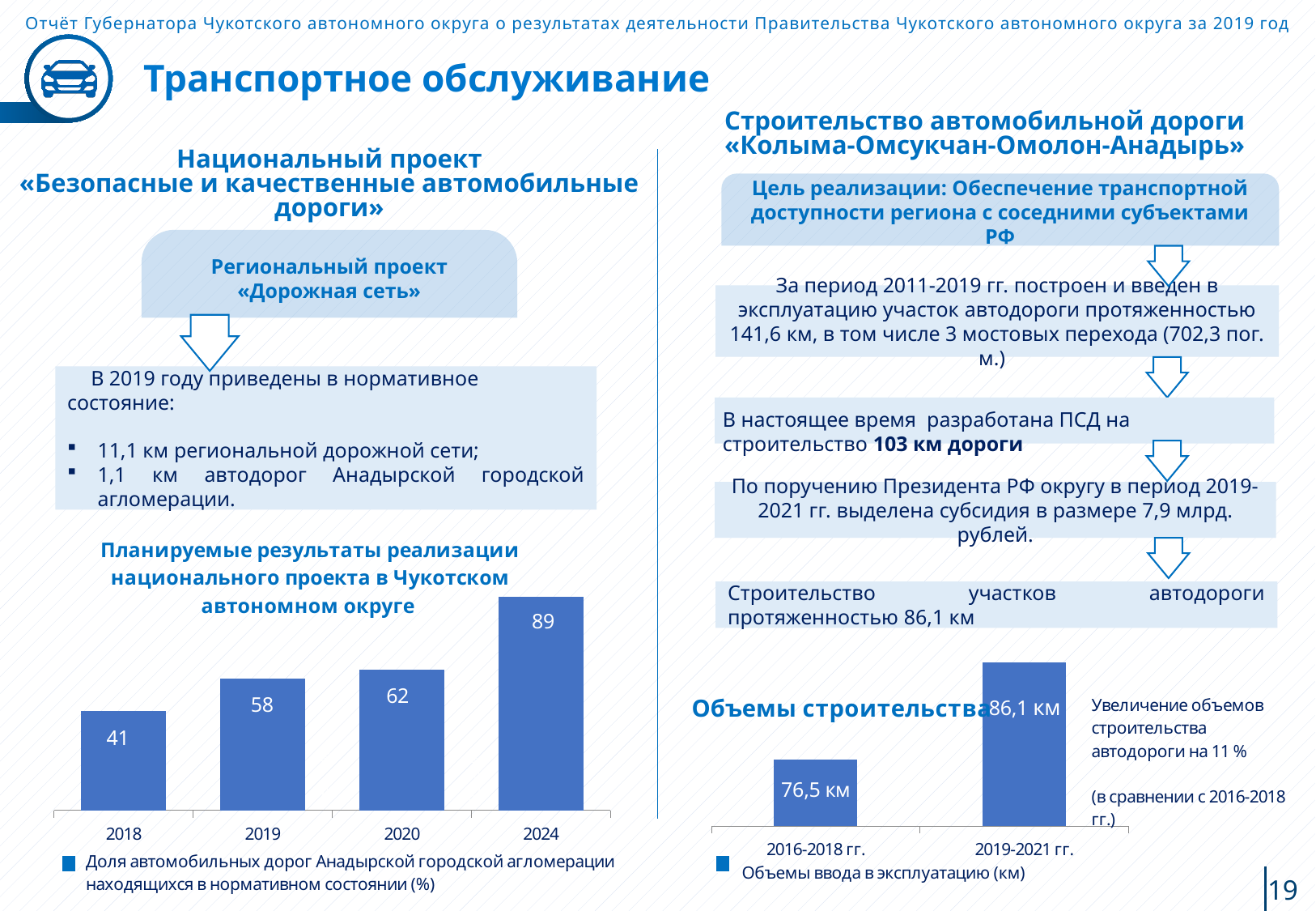
In the chart 'Планируемые результаты реализации национального проекта в Чукотском автономном округе', how many years are shown on the x axis? 4 In the chart 'Планируемые результаты реализации национального проекта в Чукотском автономном округе', which year has the lowest value? 2018 In the chart 'Планируемые результаты реализации национального проекта в Чукотском автономном округе', what is the difference between the values for 2024 and 2019? 31 In the chart 'Объемы строительства', what is the value for 2019-2021 гг.? 86,1 км In the chart 'Планируемые результаты реализации национального проекта в Чукотском автономном округе', which year has the highest value? 2024 In the chart 'Объемы строительства', which period has the larger value, 2016-2018 гг. or 2019-2021 гг.? 2019-2021 гг. In the chart 'Объемы строительства', what does the legend entry say? Объемы ввода в эксплуатацию (км) What kind of chart is 'Планируемые результаты реализации национального проекта в Чукотском автономном округе'? bar chart In the chart 'Планируемые результаты реализации национального проекта в Чукотском автономном округе', do the values rise or fall from 2018 to 2024? rise In the chart 'Объемы строительства', what is the value for 2016-2018 гг.? 76,5 км In the chart 'Планируемые результаты реализации национального проекта в Чукотском автономном округе', what is the value for 2018? 41 In the chart 'Планируемые результаты реализации национального проекта в Чукотском автономном округе', what is the value for 2020? 62